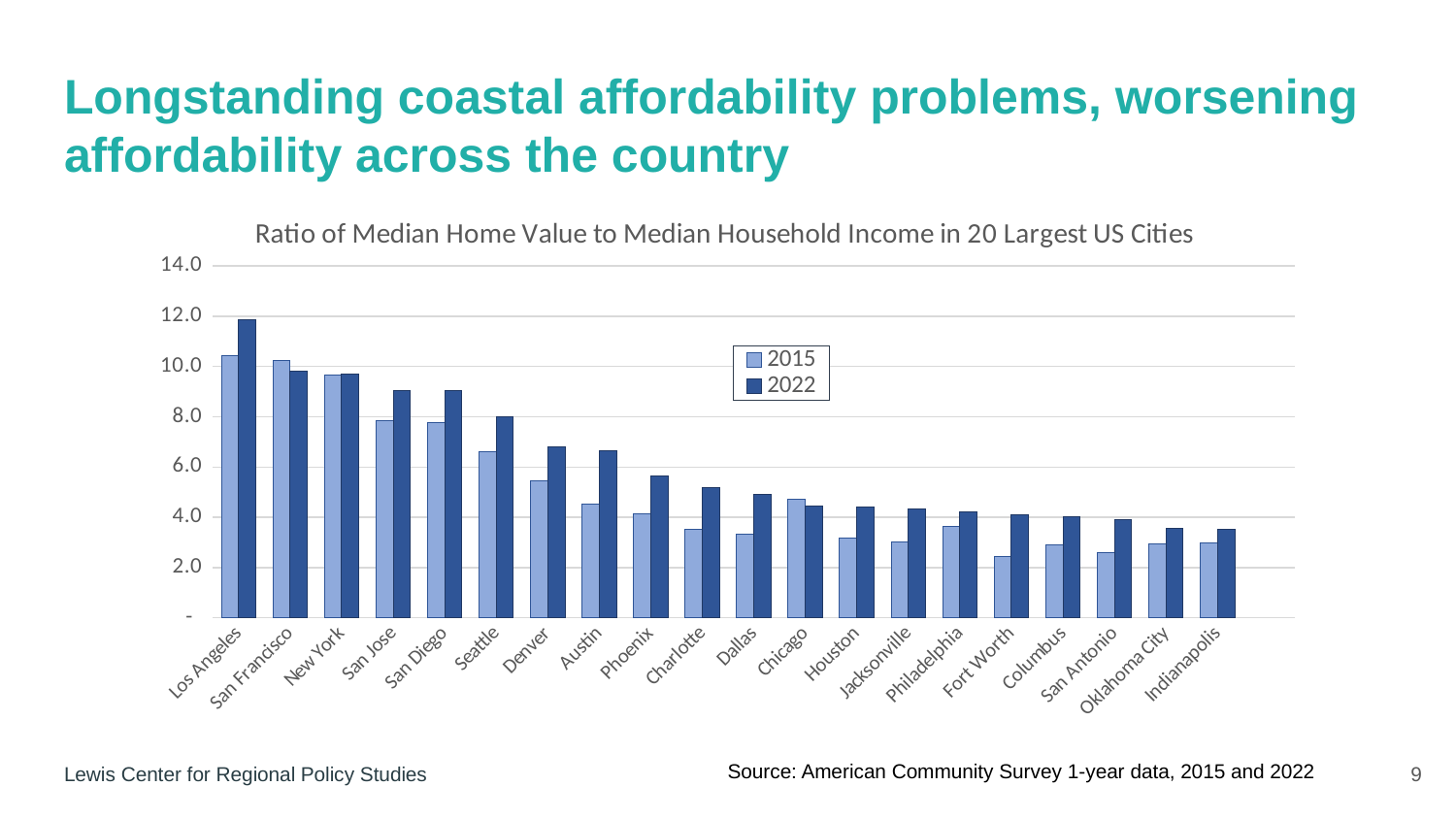
What kind of chart is shown on the slide? Bar chart Which city has the lowest ratio for 2015? Fort Worth Is the 2022 value for Austin greater or less than 6.0? greater How many series does the legend list? 2 How many cities are shown on the x axis? 20 For Chicago, which year has the larger ratio, 2015 or 2022? 2015 Is the 2015 value for Seattle greater or less than 6.0? greater What is the title of the chart? Ratio of Median Home Value to Median Household Income in 20 Largest US Cities For San Francisco, which year has the larger ratio, 2015 or 2022? 2015 Which city has the highest ratio for 2022? Los Angeles Is the 2015 value for Fort Worth greater or less than 4.0? less